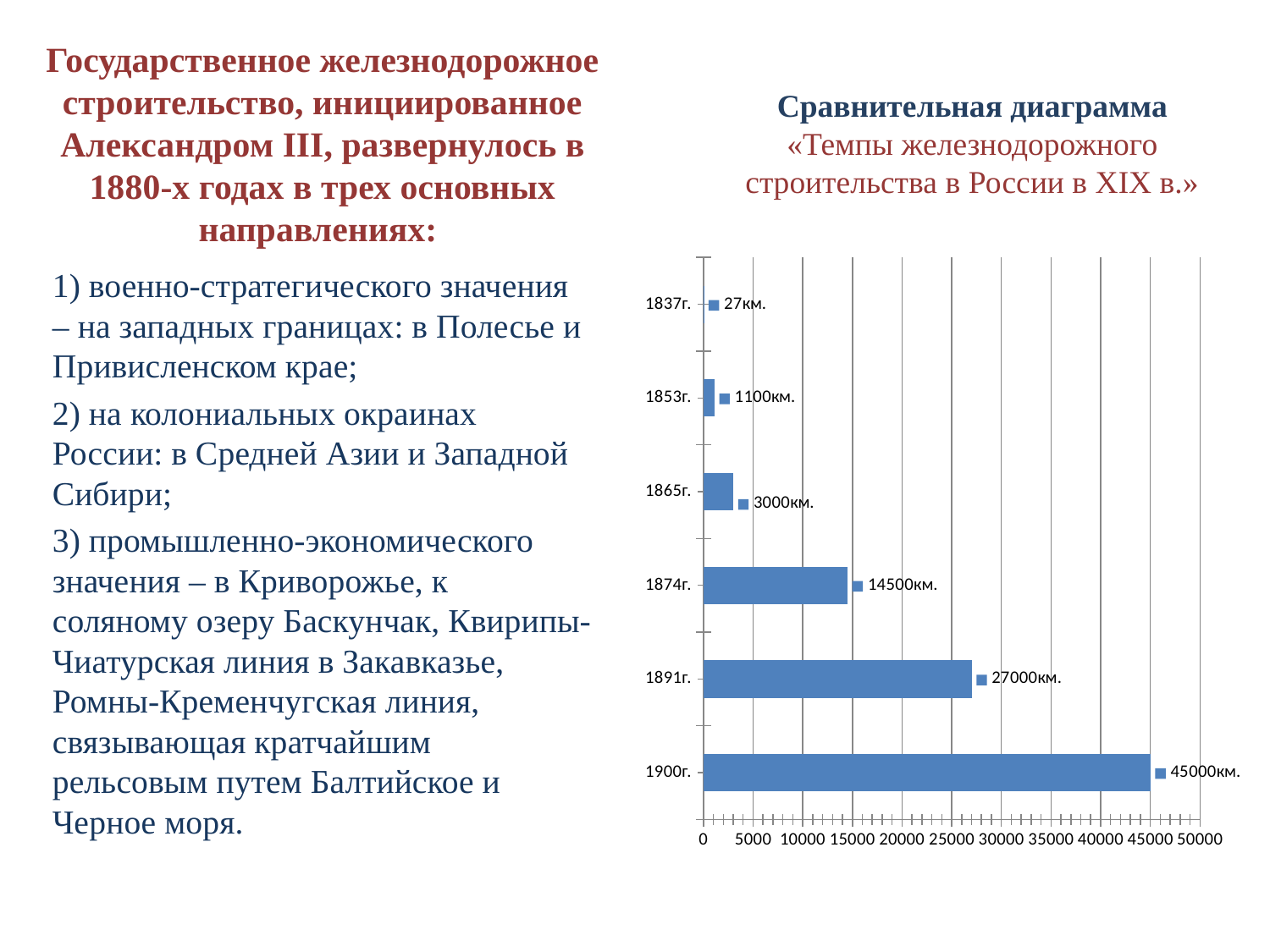
How many years are shown on the chart? 6 What is the difference between the values for 1874г. and 1865г.? 11500км. What is the title of the chart in quotation marks? «Темпы железнодорожного строительства в России в XIX в.» Which year has the highest value? 1900г. What kind of chart is shown on the slide? bar chart What value is shown for 1900г.? 45000км. What value is shown for 1874г.? 14500км. What is the difference between the values for 1900г. and 1891г.? 18000км. What value is shown for 1837г.? 27км. Which is larger, the value for 1853г. or the value for 1865г.? 1865г. Is the value for 1891г. greater or less than 25000? greater Which year has the lowest value? 1837г.